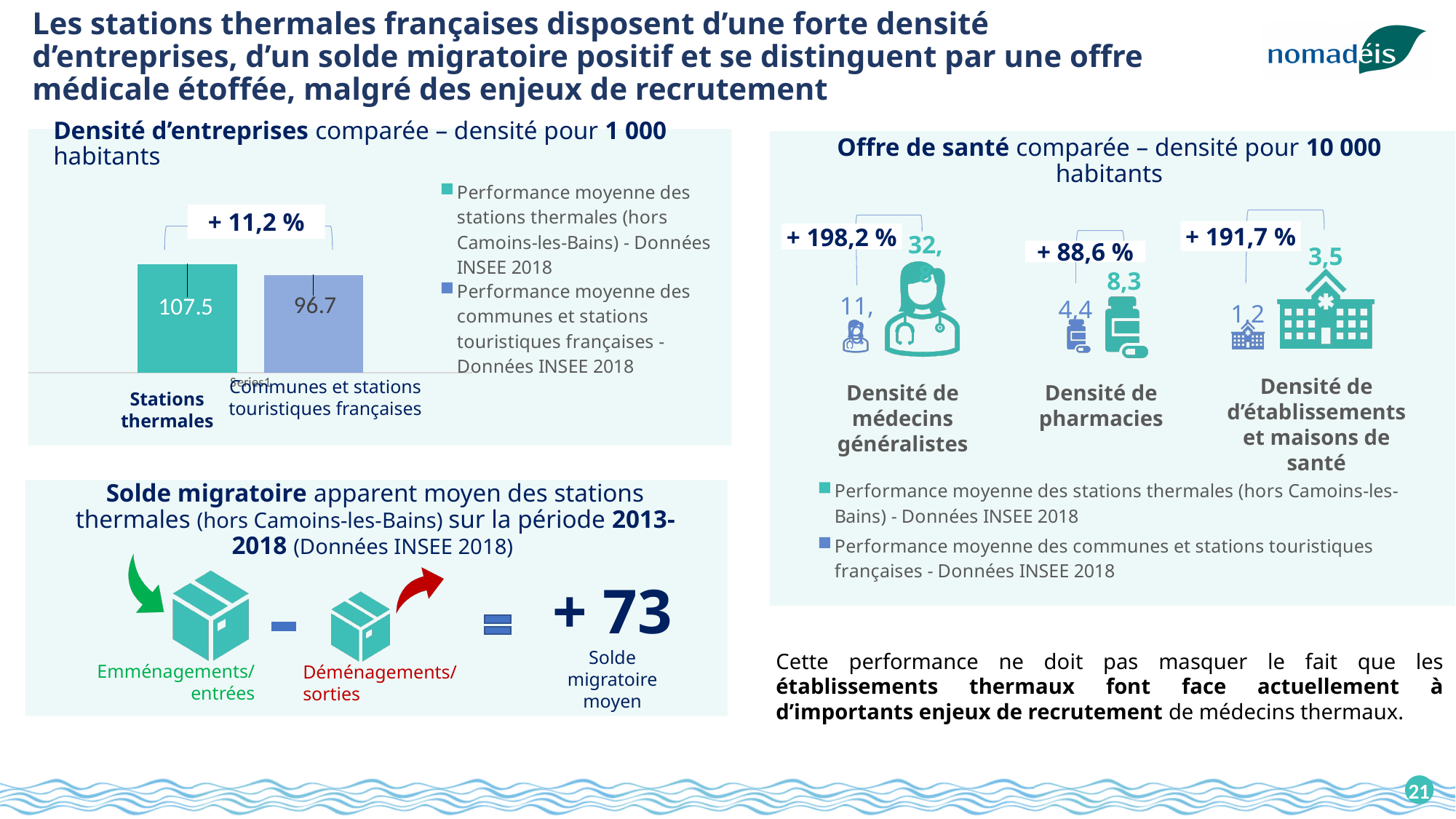
In the 'Densité d'entreprises comparée' chart, what is the difference between the Stations thermales value and the Communes et stations touristiques françaises value? 10.8 In the 'Densité d'entreprises comparée' chart, which category has the lowest value? Communes et stations touristiques françaises In the 'Densité d'entreprises comparée' chart, which category has the highest value? Stations thermales In the 'Densité d'entreprises comparée' chart, what is the value for Stations thermales? 107.5 In the 'Densité d'entreprises comparée' chart, what percentage difference is annotated above the bars? + 11,2 % What type of chart is the 'Densité d'entreprises comparée' chart? Bar chart In the 'Densité d'entreprises comparée' chart, how many entries does the legend list? 2 In the 'Densité d'entreprises comparée' chart, how many bars are plotted? 2 In the 'Offre de santé comparée' graphic, what is the Densité de pharmacies value for the communes et stations touristiques françaises (blue figure)? 4,4 In the 'Offre de santé comparée' graphic, what is the Densité de pharmacies value for the stations thermales (teal figure)? 8,3 In the 'Densité d'entreprises comparée' chart, what is the value for Communes et stations touristiques françaises? 96.7 In the 'Offre de santé comparée' graphic, what is the Densité d'établissements et maisons de santé value for the stations thermales (teal figure)? 3,5